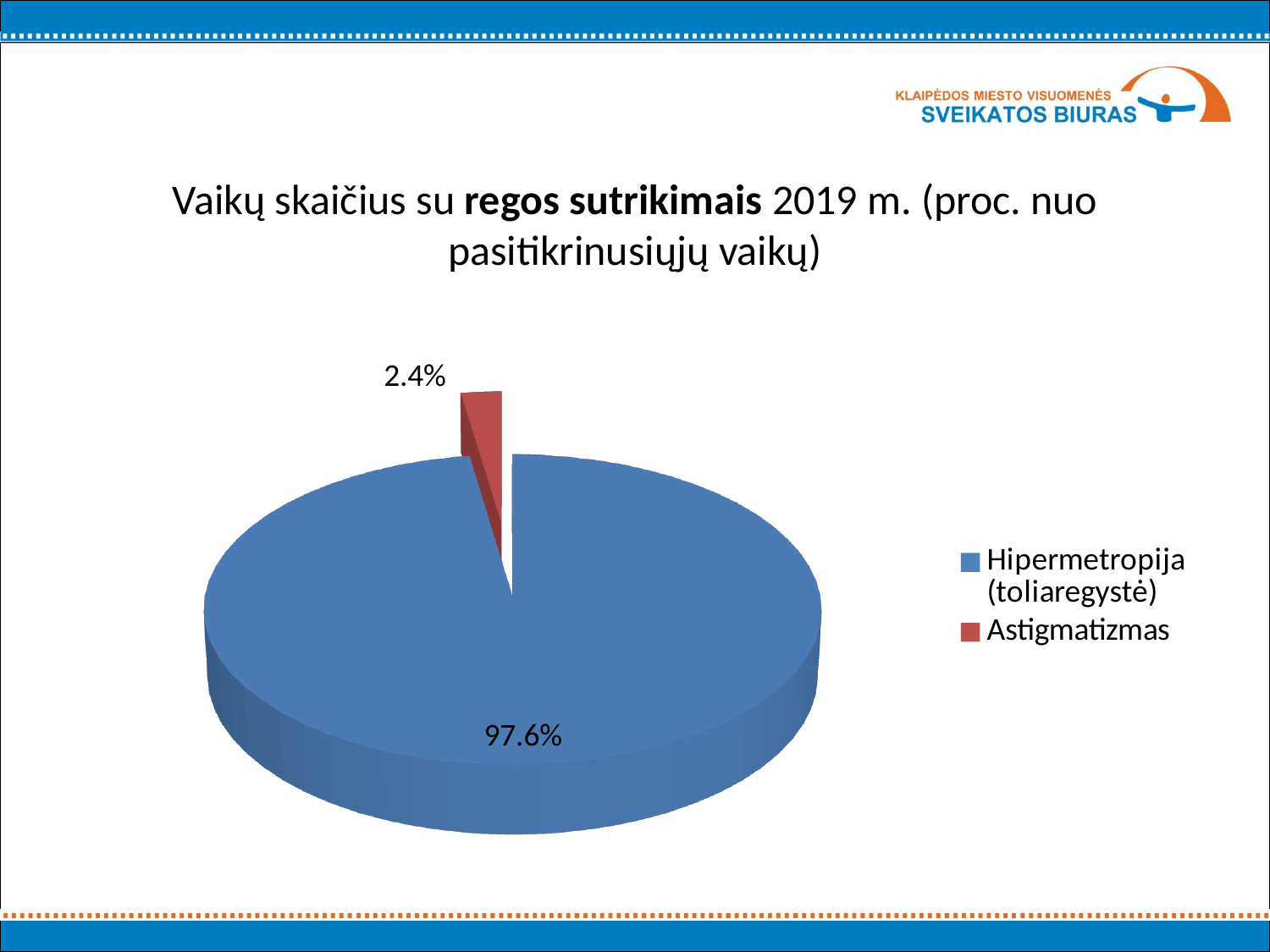
What share of the pie does Astigmatizmas represent? 2.4% Which category has the largest slice of the pie? Hipermetropija (toliaregystė) What colour is the Astigmatizmas slice? red Which category has the smallest slice of the pie? Astigmatizmas What year does the chart title refer to? 2019 What share of the pie does Hipermetropija (toliaregystė) represent? 97.6% How many categories does the pie chart show? 2 What is the difference in percentage points between the Hipermetropija (toliaregystė) slice and the Astigmatizmas slice? 95.2 How many entries does the legend list? 2 Which is larger, the slice for Astigmatizmas or the slice for Hipermetropija (toliaregystė)? Hipermetropija (toliaregystė) What kind of chart is shown on the slide? pie chart